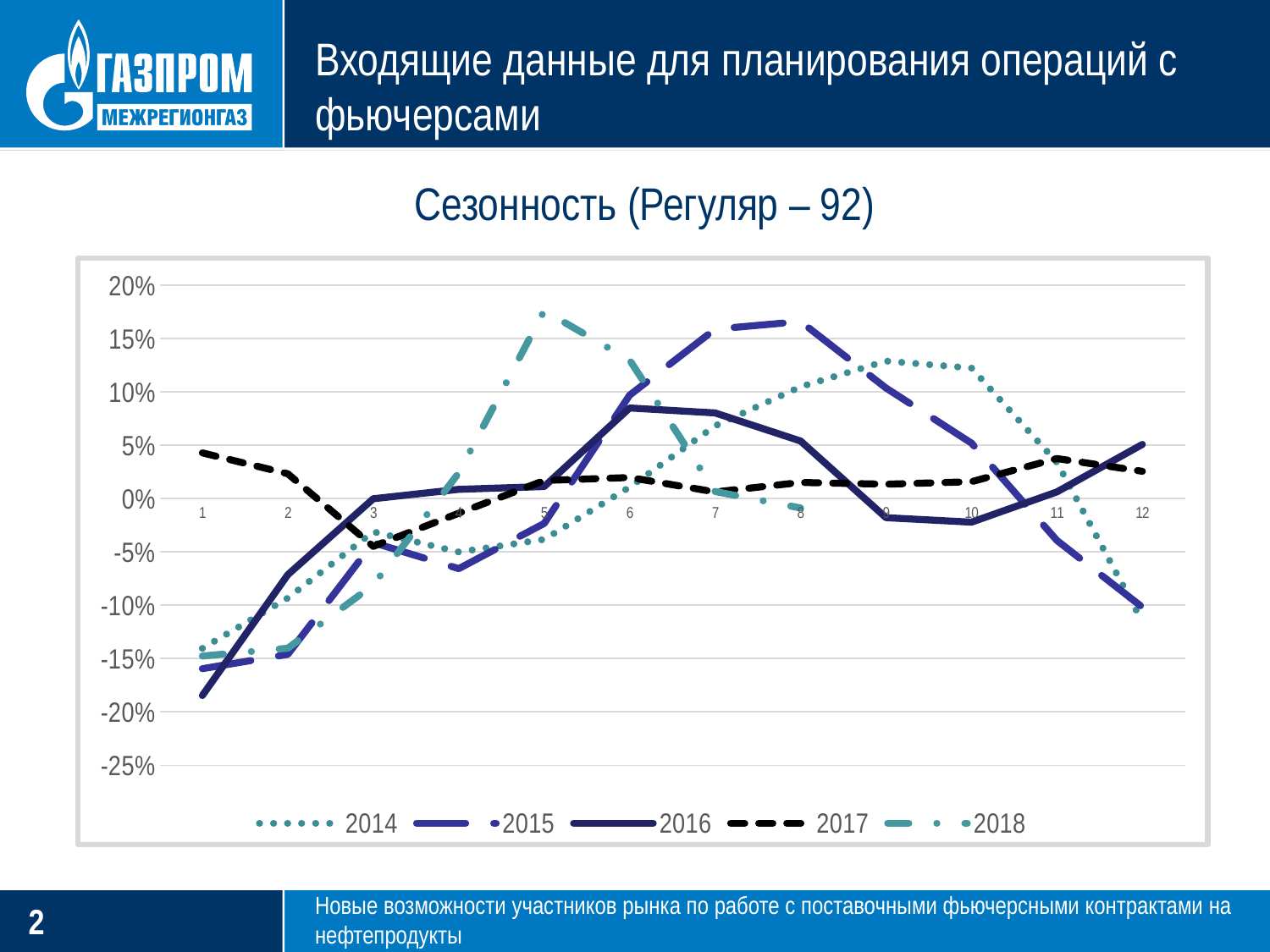
What kind of chart is shown on the slide? line chart Is the value for 2016 at point 1 greater or less than -15%? less How many points are there along the x axis? 12 Does the 2017 series rise or fall from point 1 to point 3? fall Is the value for 2014 at point 9 greater or less than 10%? greater Is the value for 2015 at point 8 greater or less than 15%? greater Does the 2016 series rise or fall from point 1 to point 6? rise How many series does the legend list? 5 What is the title of the chart? Сезонность (Регуляр – 92) Which years are listed in the legend? 2014, 2015, 2016, 2017, 2018